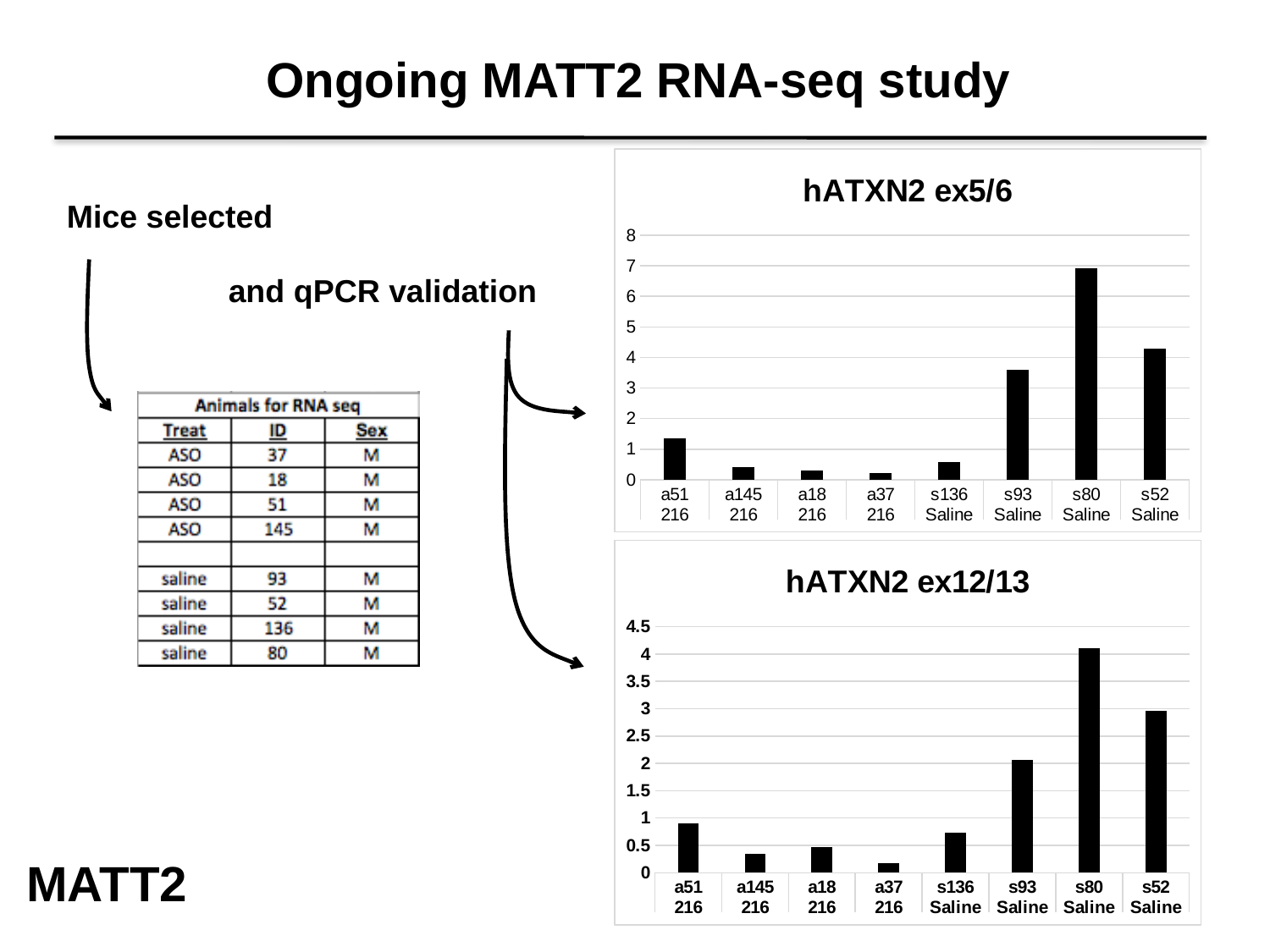
In the "hATXN2 ex5/6" chart, is the value for s93 Saline greater or less than 4? less How many categories are shown on the x axis of the "hATXN2 ex12/13" chart? 8 What type of chart is the "hATXN2 ex5/6" chart? bar chart In the "hATXN2 ex12/13" chart, is the value for a51 216 greater or less than 1? less In the "hATXN2 ex5/6" chart, which category has the highest value? s80 Saline In the "hATXN2 ex12/13" chart, which category has the lowest value? a37 216 In the "hATXN2 ex5/6" chart, which is larger, the value for s52 Saline or the value for s93 Saline? s52 Saline In the "hATXN2 ex12/13" chart, which category has the highest value? s80 Saline In the "hATXN2 ex5/6" chart, is the value for a51 216 greater or less than 1? greater What is the title of the lower chart on the slide? hATXN2 ex12/13